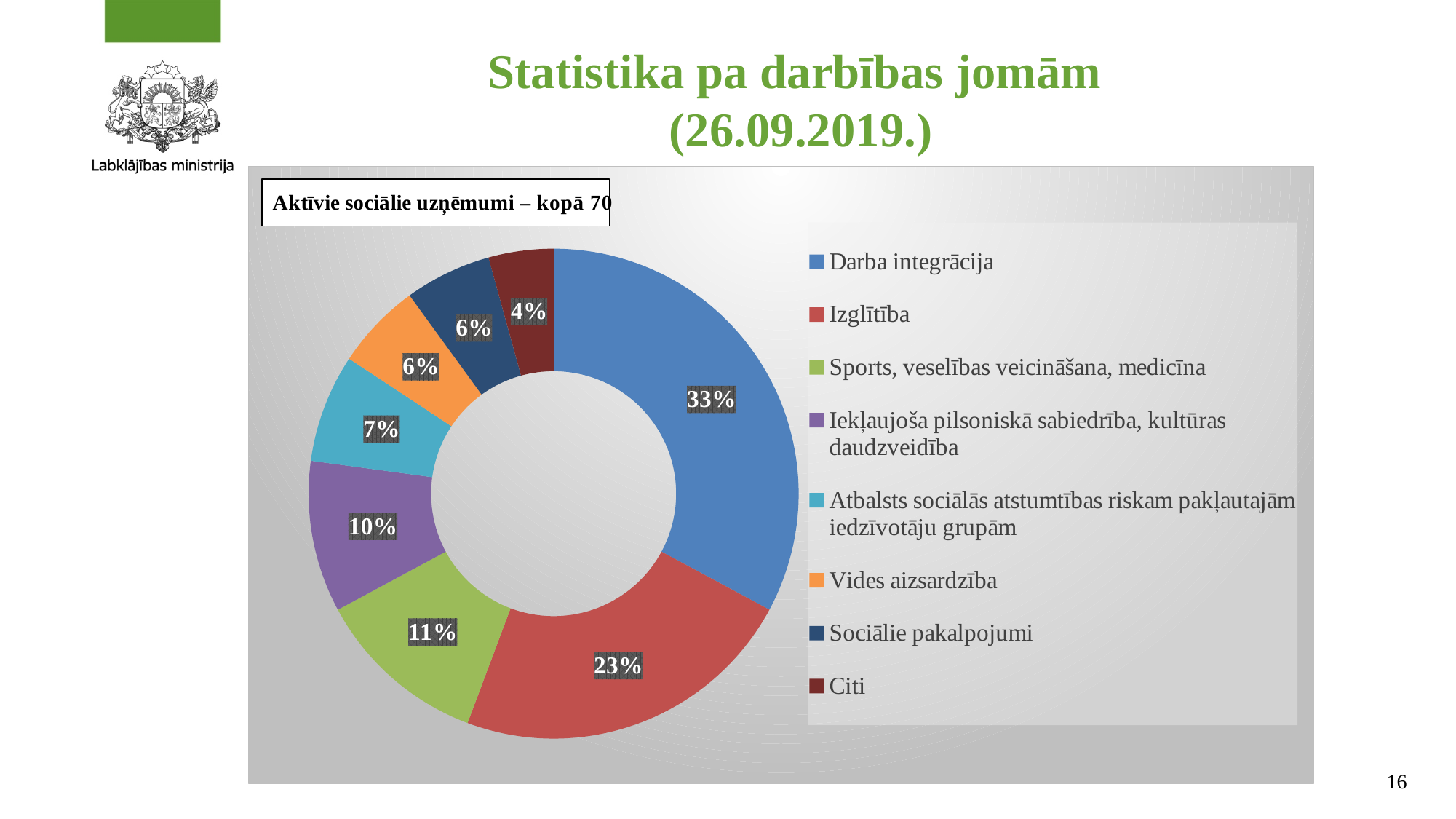
What share of the chart does Darba integrācija represent? 33% What percentage is shown for Vides aizsardzība? 6% Which category has the smallest share of the chart? Citi What percentage is shown for Sports, veselības veicināšana, medicīna? 11% What is the difference in percentage points between Darba integrācija and Izglītība? 10 What percentage is shown for Iekļaujoša pilsoniskā sabiedrība, kultūras daudzveidība? 10% What is the title shown in the box above the chart? Aktīvie sociālie uzņēmumi – kopā 70 Which category has the largest share of the chart? Darba integrācija Which has a larger share: Sports, veselības veicināšana, medicīna or Atbalsts sociālās atstumtības riskam pakļautajām iedzīvotāju grupām? Sports, veselības veicināšana, medicīna What kind of chart is shown on the slide? Doughnut (pie) chart What percentage is shown for Izglītība? 23% How many categories does the chart show? 8